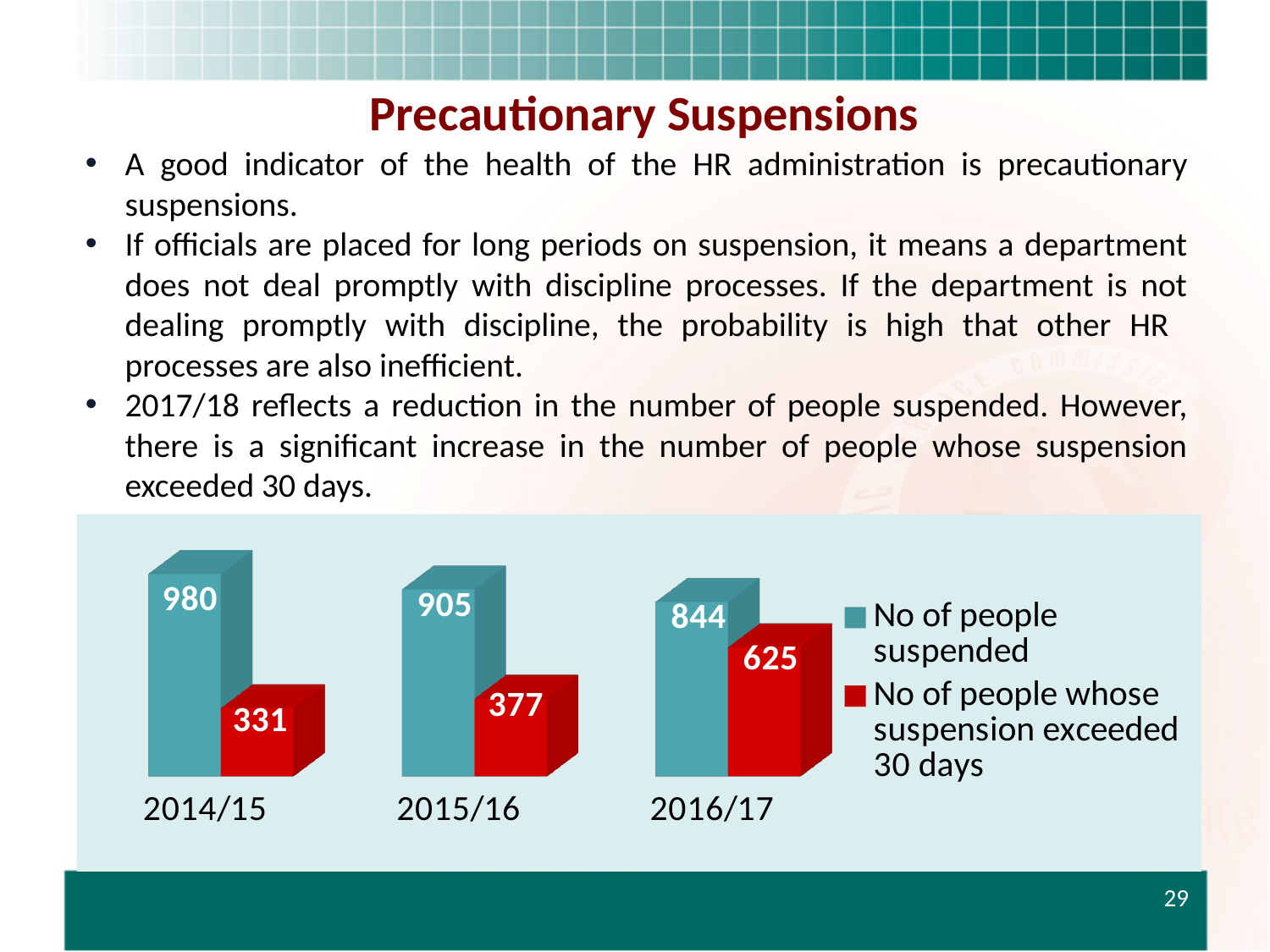
Does the number of people suspended rise or fall from 2014/15 to 2016/17? Fall How many years are shown on the chart? 3 What is the number of people whose suspension exceeded 30 days in 2016/17? 625 What is the difference between the number of people suspended and the number whose suspension exceeded 30 days in 2016/17? 219 How many series does the legend list? 2 What kind of chart is shown on the slide? Bar chart What colour represents the number of people whose suspension exceeded 30 days? Red Which year has the highest number of people suspended? 2014/15 What is the number of people whose suspension exceeded 30 days in 2015/16? 377 Which is larger: the number of people suspended in 2015/16 or in 2016/17? 2015/16 What is the number of people suspended in 2014/15? 980 Which year has the lowest number of people whose suspension exceeded 30 days? 2014/15